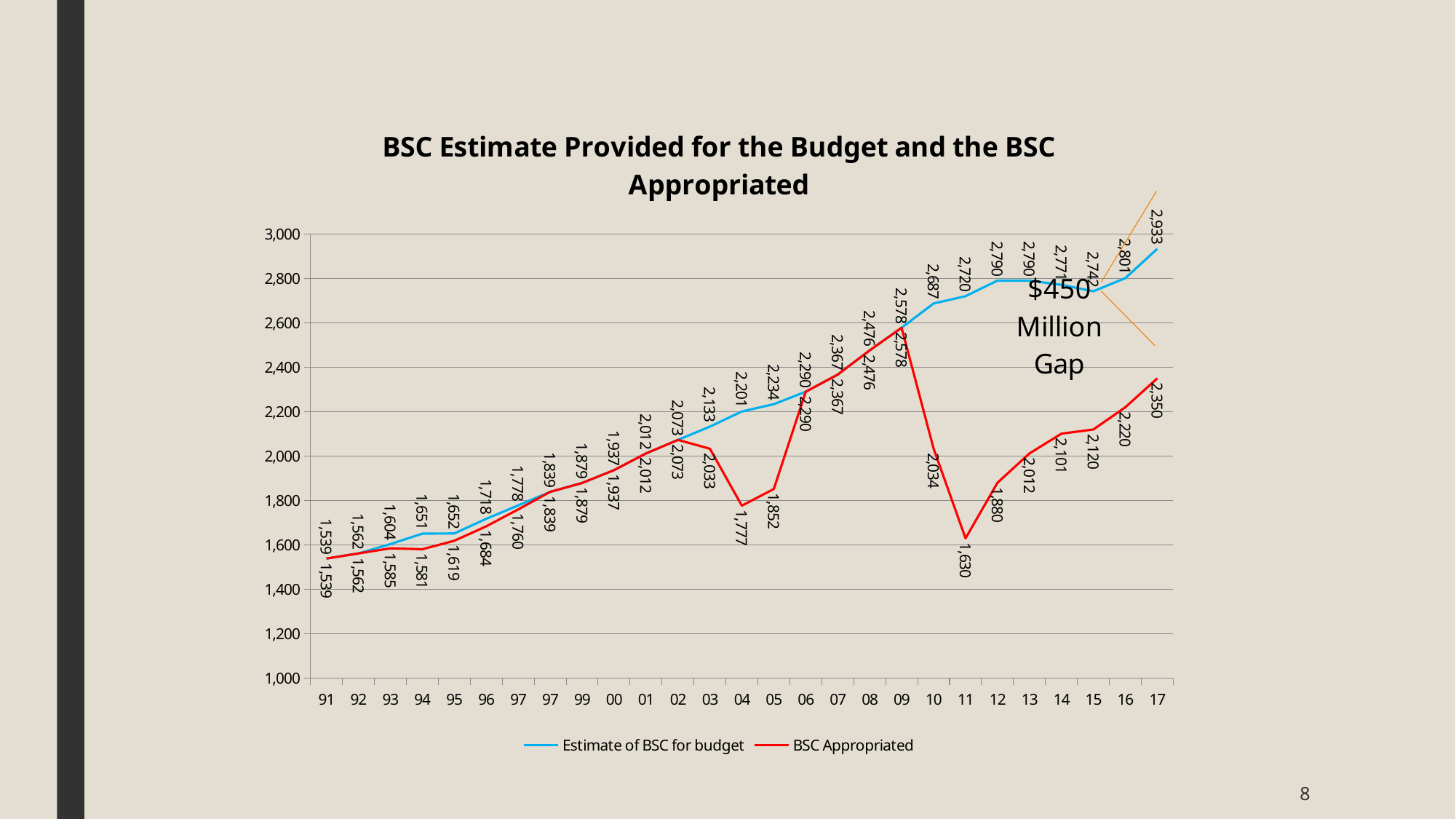
What text annotation is placed near the right side of the chart between the two lines? $450 Million Gap In which year does the Estimate of BSC for budget series reach its highest value? 17 How many years are plotted along the x axis? 27 What is the difference between the Estimate of BSC for budget and BSC Appropriated in 11? 1,090 What is the Estimate of BSC for budget value for 17? 2,933 What is the BSC Appropriated value for 11? 1,630 In 04, which series has the larger value, Estimate of BSC for budget or BSC Appropriated? Estimate of BSC for budget What kind of chart is shown on the slide? line chart What is the difference between the Estimate of BSC for budget and BSC Appropriated in 17? 583 In which year does the BSC Appropriated series reach its highest value? 09 How many series does the legend list? 2 What is the BSC Appropriated value for 04? 1,777